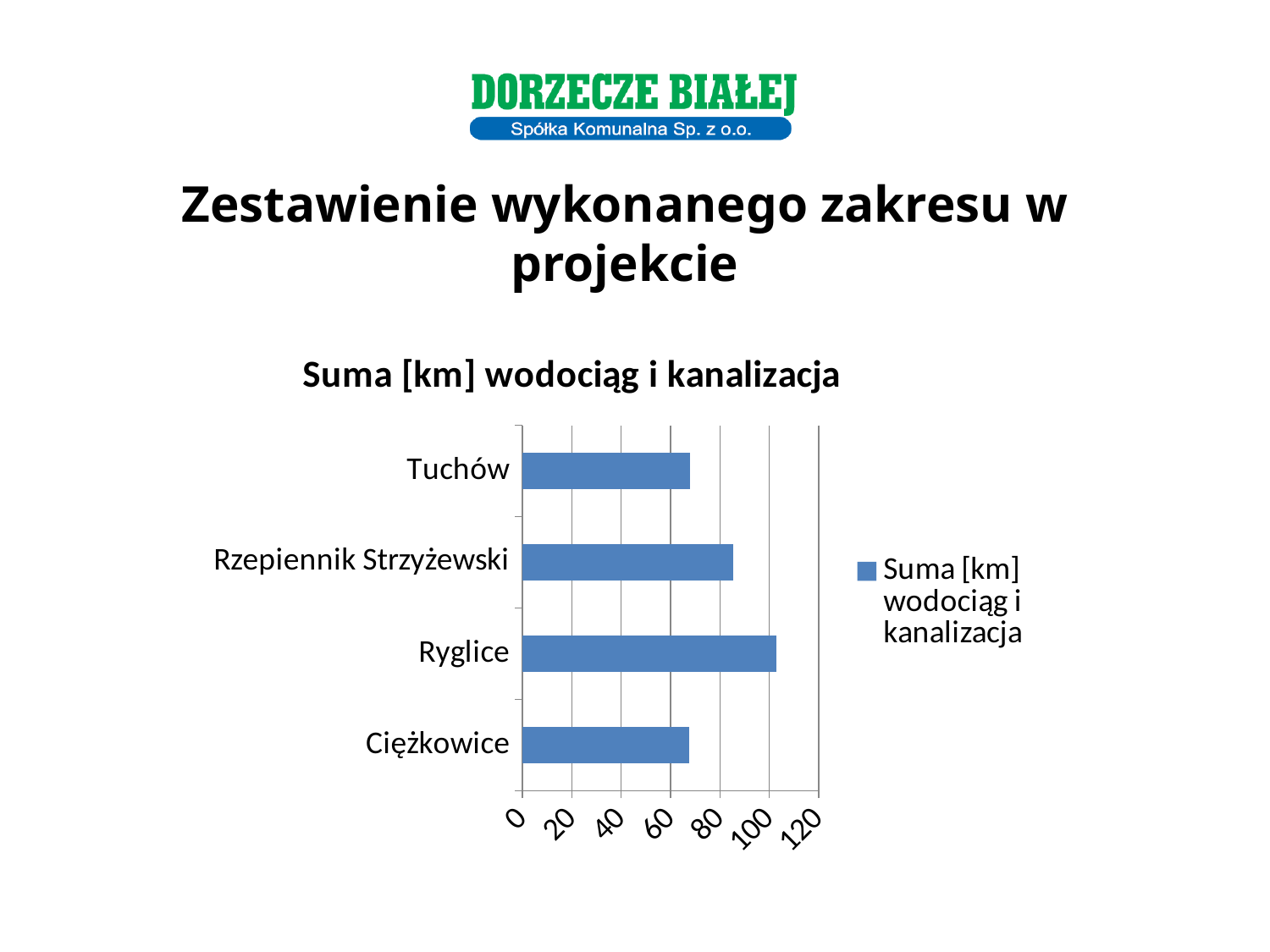
What is the highest value shown on the horizontal axis? 120 Which is larger, the value for Ryglice or the value for Rzepiennik Strzyżewski? Ryglice How many series does the legend list? 1 What is the title of the chart? Suma [km] wodociąg i kanalizacja Which category has the highest value? Ryglice Is the value for Rzepiennik Strzyżewski greater or less than 80? greater What kind of chart is shown on the slide? bar chart Is the value for Ciężkowice greater or less than 60? greater Is the value for Ryglice greater or less than 100? greater How many categories are plotted in the chart? 4 Which is larger, the value for Rzepiennik Strzyżewski or the value for Tuchów? Rzepiennik Strzyżewski